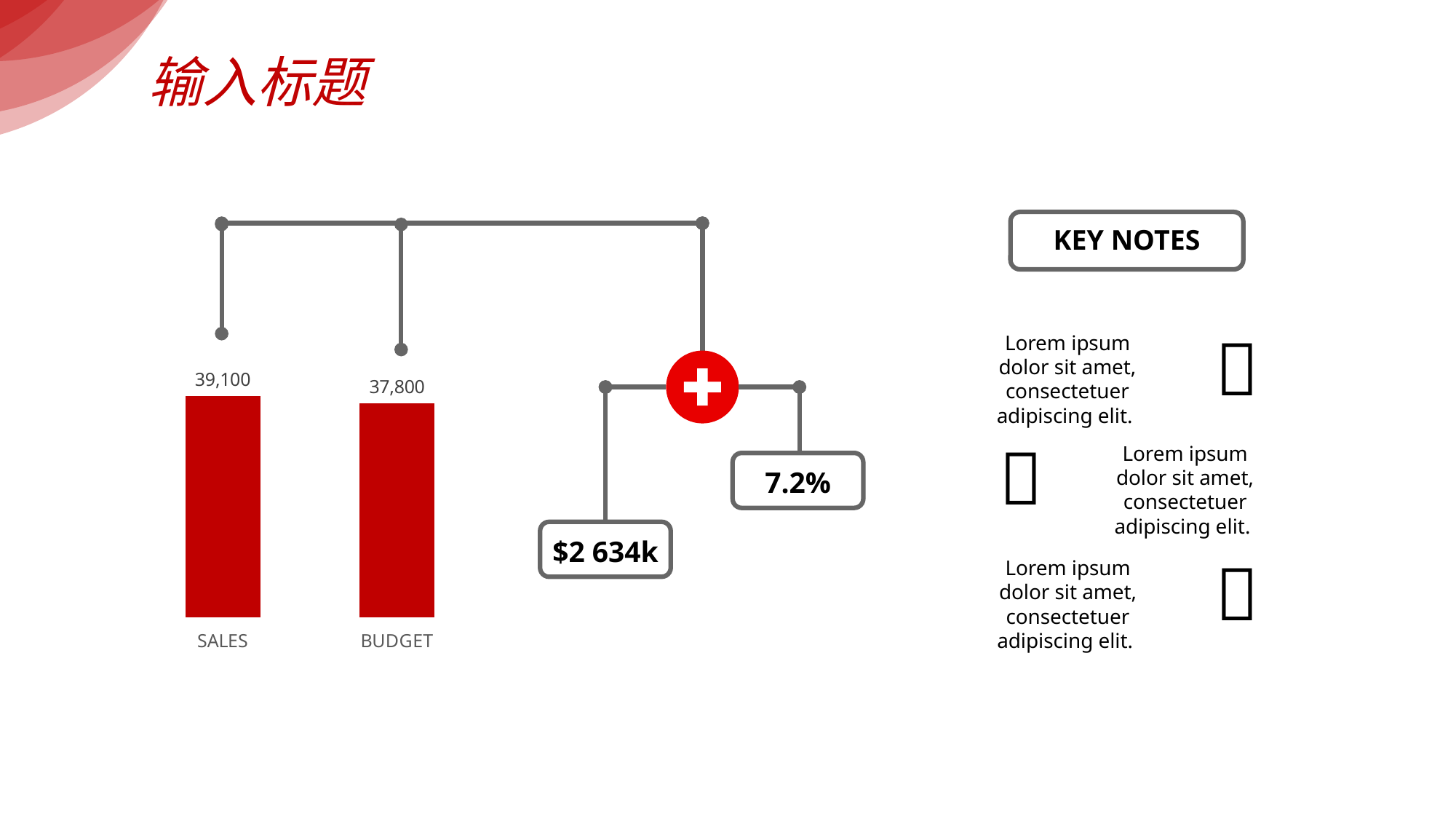
What percentage value is shown in the box connected to the plus symbol? 7.2% What colour are the bars in the chart? Red What kind of chart is shown on the left of the slide? Bar chart What dollar value is shown in the box connected to the plus symbol? $2 634k Which category has the higher bar, SALES or BUDGET? SALES Which category has the highest value in the bar chart? SALES What is the difference between the SALES value and the BUDGET value? 1,300 How many bars are shown in the bar chart? 2 What is the value shown for SALES in the bar chart? 39,100 Which category has the lowest value in the bar chart? BUDGET What are the category labels under the two bars? SALES and BUDGET What is the value shown for BUDGET in the bar chart? 37,800